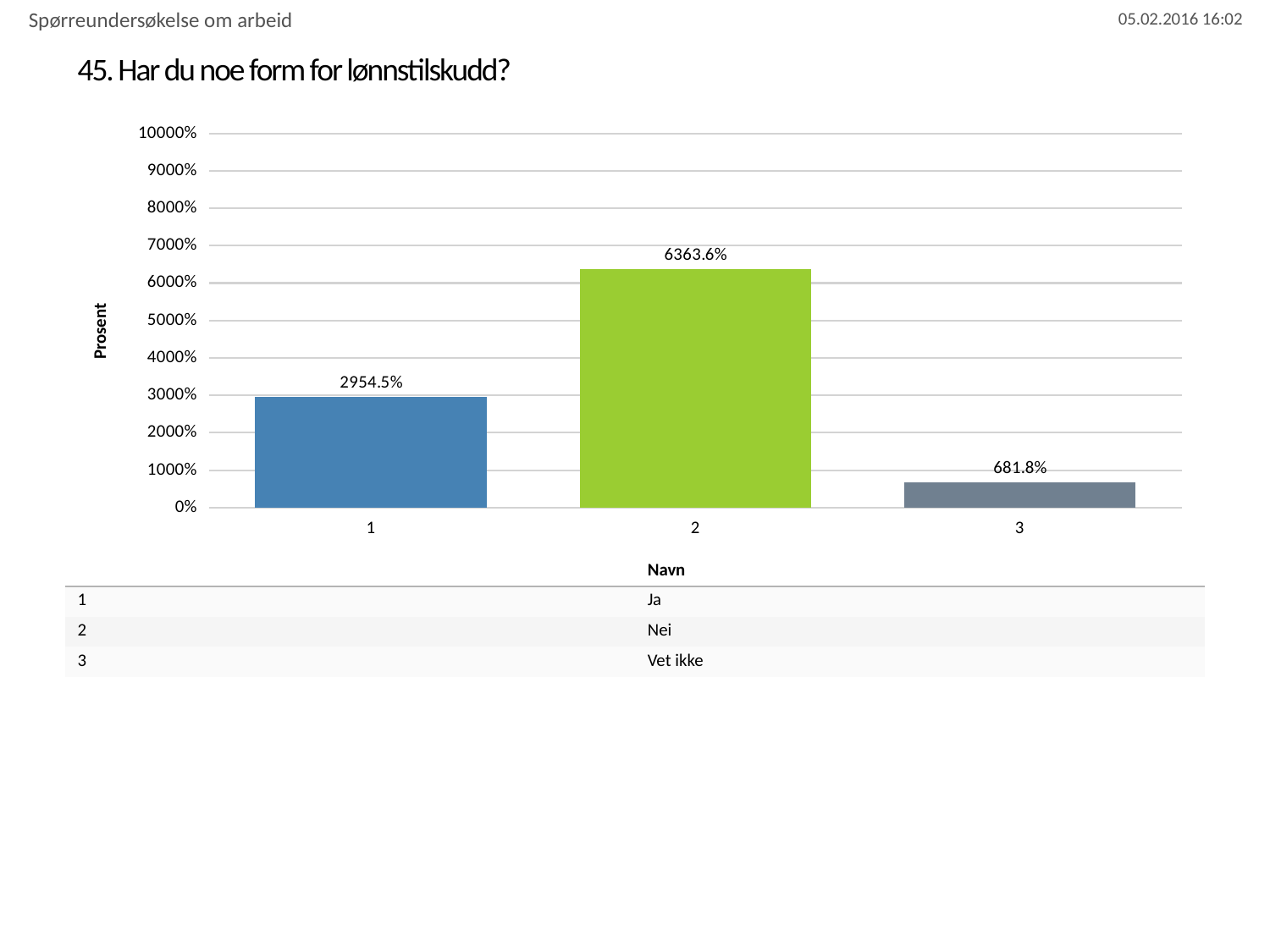
What kind of chart is shown on the slide? Bar chart Is the value for category 2 greater or less than 5000%? greater What is the difference between the values for category 2 and category 1? 3409.1% What is the difference between the values for category 1 and category 3? 2272.7% How many categories are plotted in the chart? 3 Which category has the highest value? 2 (Nei) What is the value shown for category 1 (Ja)? 2954.5% Which category has the lowest value? 3 (Vet ikke) What is the label of the vertical axis? Prosent What is the value shown for category 2 (Nei)? 6363.6% What is the value shown for category 3 (Vet ikke)? 681.8% Which is larger, the value for category 1 or the value for category 3? Category 1